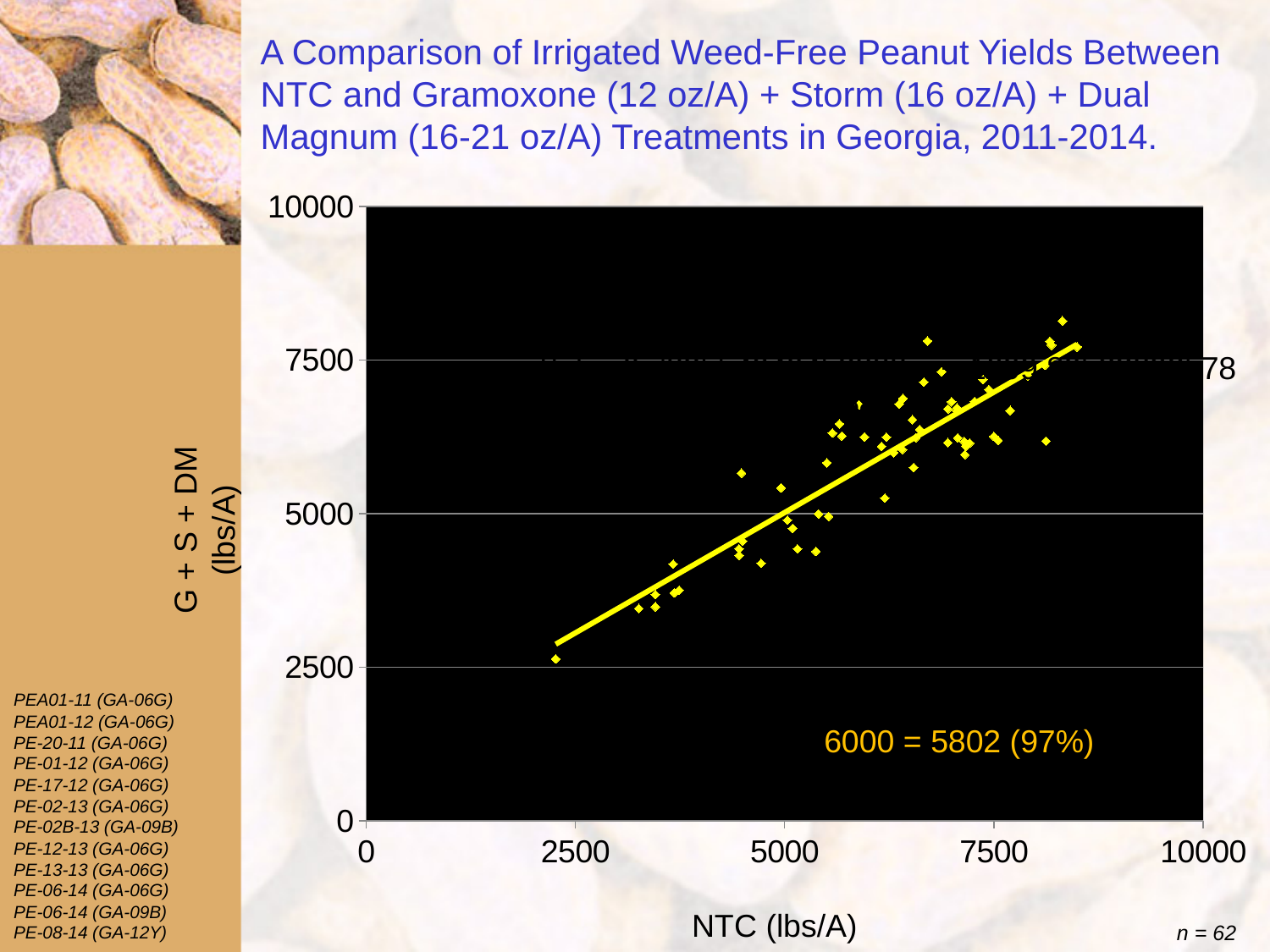
Is the y value of the highest plotted point greater or less than 7500? greater What is the label of the y axis? G + S + DM (lbs/A) Do the plotted values generally rise or fall as the NTC yield increases along the x axis? rise What is the label of the x axis? NTC (lbs/A) How many observations (n) does the chart report? 62 According to the annotation on the chart, what G + S + DM yield corresponds to an NTC yield of 6000? 5802 What percentage is shown in the annotation '6000 = 5802 (...)' on the chart? 97% Is the x value of the rightmost plotted point greater or less than 7500? greater Is the x value of the leftmost plotted point greater or less than 2500? less What kind of chart is shown on the slide? scatter chart What is the maximum value shown on the y axis? 10000